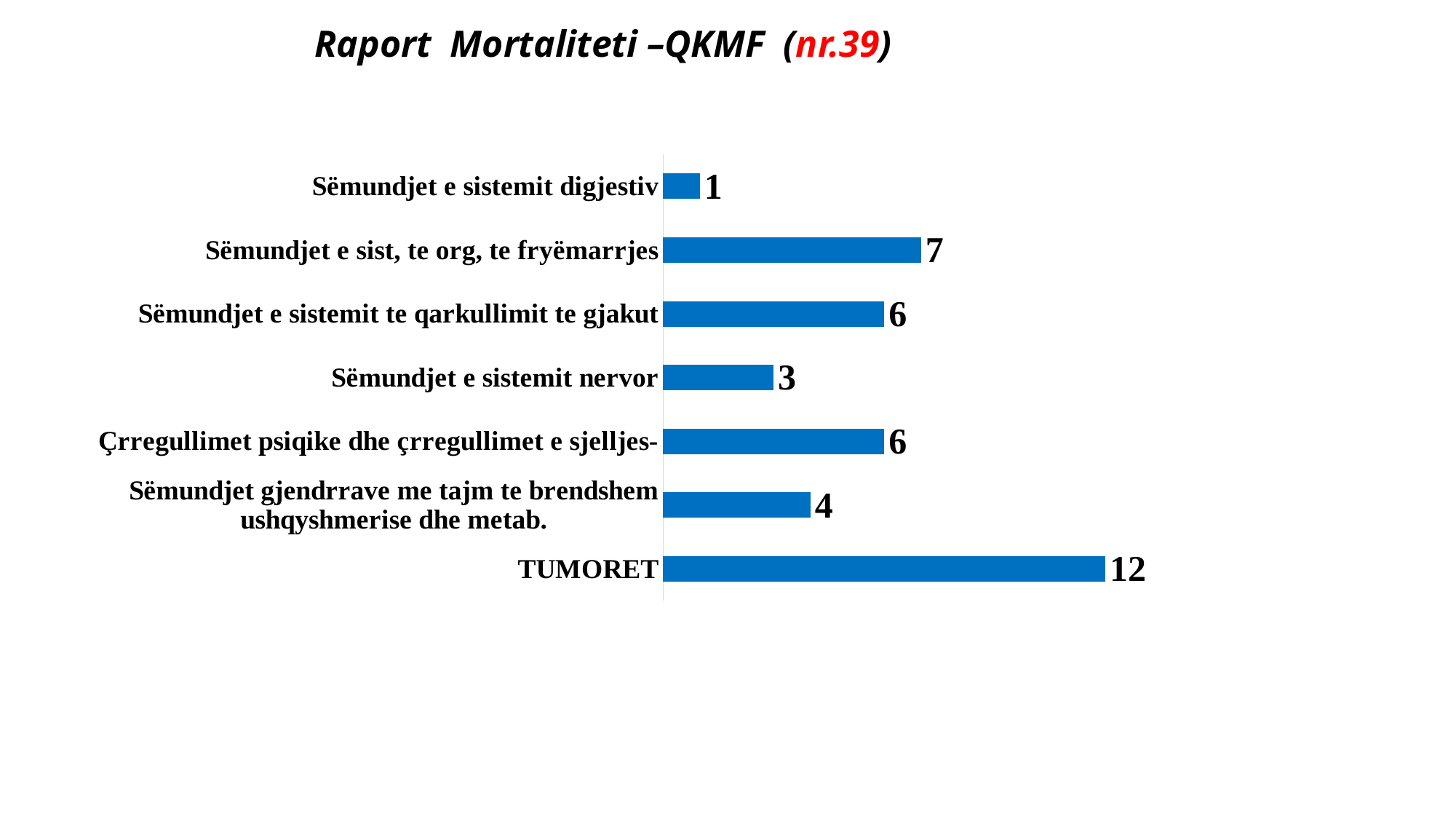
What is the difference between the value for TUMORET and the value for Sëmundjet e sist, te org, te fryëmarrjes? 5 What colour are the bars in the chart? Blue How many categories are shown in the chart? 7 What is the title of the slide? Raport Mortaliteti –QKMF (nr.39) What is the value for Sëmundjet e sistemit nervor? 3 What is the value for Sëmundjet e sist, te org, te fryëmarrjes? 7 What is the value for Sëmundjet e sistemit digjestiv? 1 Which is larger: the value for Sëmundjet e sistemit nervor or the value for Sëmundjet gjendrrave me tajm te brendshem ushqyshmerise dhe metab.? Sëmundjet gjendrrave me tajm te brendshem ushqyshmerise dhe metab. What is the value for TUMORET? 12 Which category has the lowest value? Sëmundjet e sistemit digjestiv What kind of chart is shown on the slide? Bar chart Which category has the highest value? TUMORET